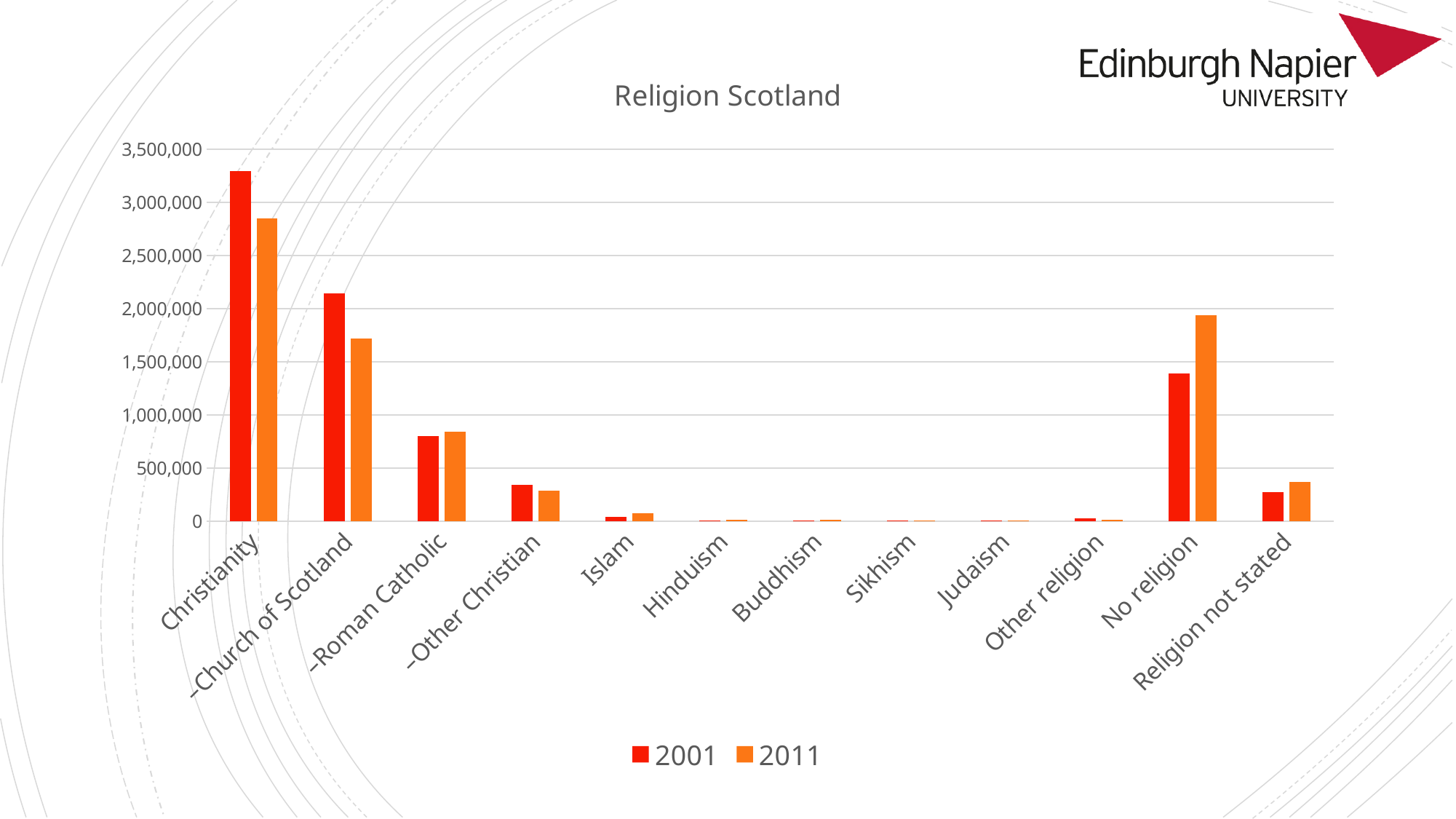
What is the title of the chart? Religion Scotland Is the 2001 value for No religion greater or less than 1,500,000? less Is the 2001 value for Christianity greater or less than 3,000,000? greater Is the 2011 value for Christianity greater or less than 3,000,000? less Which category has the highest value for 2001? Christianity How many categories are shown on the x axis? 12 Which category has the highest value for 2011? Christianity How many series does the legend list? 2 For No religion, which year has the larger value, 2001 or 2011? 2011 What kind of chart is shown on the slide? bar chart For Church of Scotland, which year has the larger value, 2001 or 2011? 2001